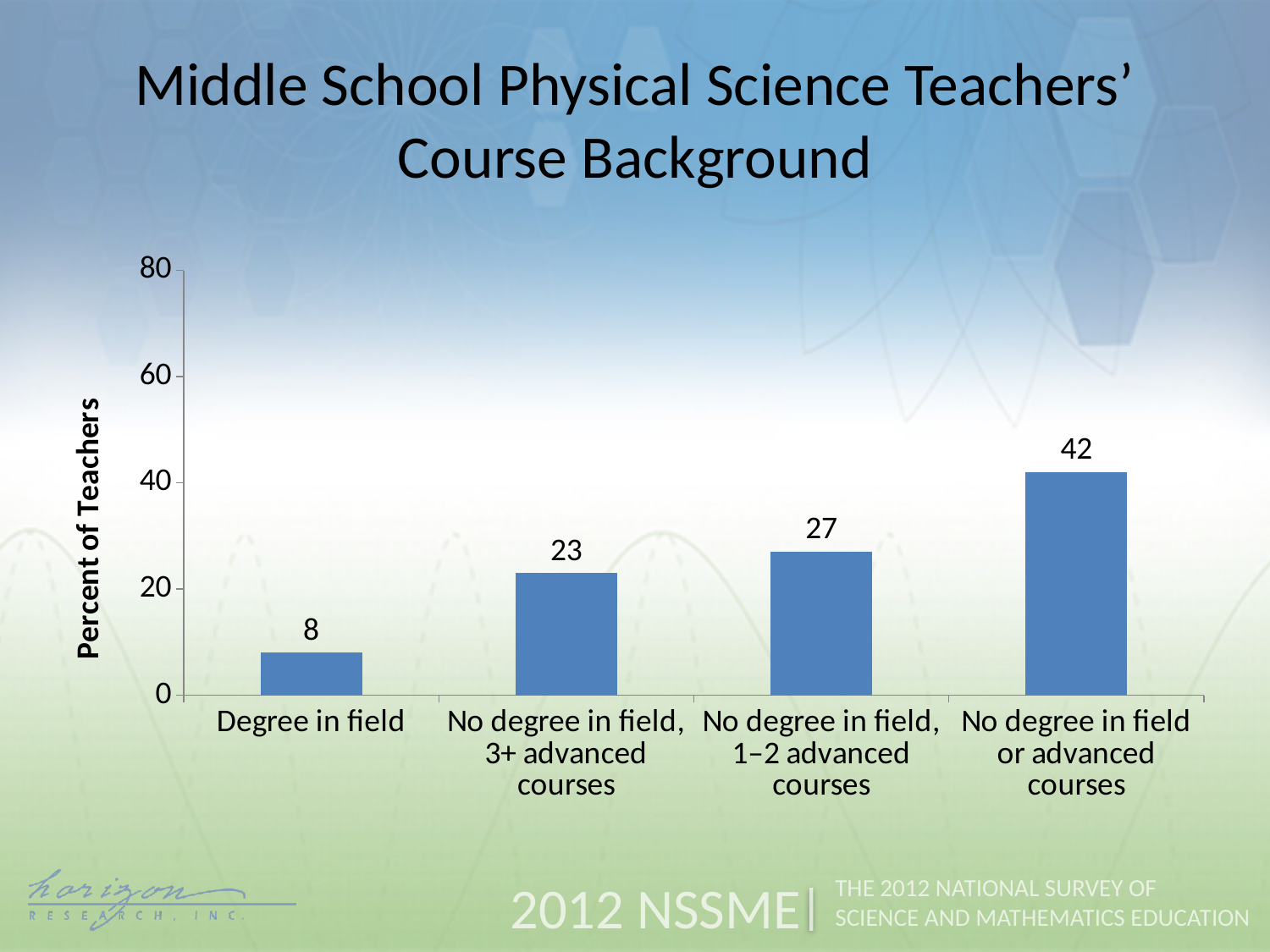
What is the value for 'No degree in field, 1–2 advanced courses'? 27 What percent of teachers have a degree in field? 8 What is the value for 'No degree in field, 3+ advanced courses'? 23 What is the label of the y axis? Percent of Teachers Which category has the highest percent of teachers? No degree in field or advanced courses Which is larger: 'No degree in field, 3+ advanced courses' or 'No degree in field, 1–2 advanced courses'? No degree in field, 1–2 advanced courses What is the value for 'No degree in field or advanced courses'? 42 Which category has the lowest percent of teachers? Degree in field What kind of chart is shown on the slide? Bar chart How many categories are shown on the x axis? 4 Is the value for 'No degree in field or advanced courses' greater or less than 40? greater What is the difference between 'No degree in field or advanced courses' and 'Degree in field'? 34